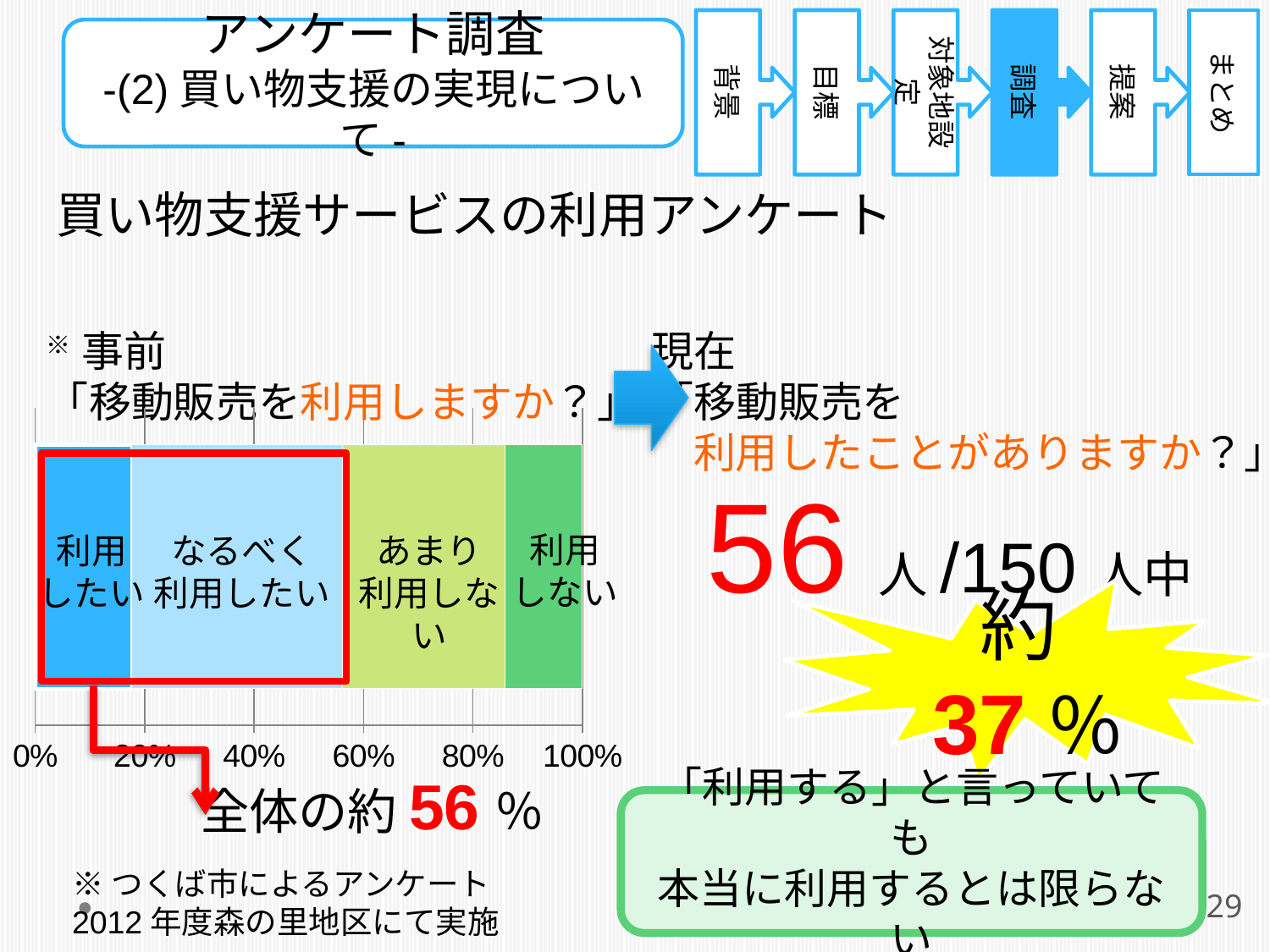
How many response categories are shown in the stacked bar? 4 Is the segment for なるべく利用したい greater or less than 20%? greater Is the segment for 利用しない greater or less than 20%? less Which two response categories are enclosed by the red box on the bar chart? 利用したい and なるべく利用したい What kind of chart is shown on the slide? Stacked bar chart Is the segment for 利用したい greater or less than 20%? less Which segment is larger, なるべく利用したい or 利用したい? なるべく利用したい Which segment is larger, あまり利用しない or 利用しない? あまり利用しない Which response category occupies the largest segment of the bar? なるべく利用したい According to the text below the chart, what share of the total do the red-boxed segments represent? 約56% What is the highest value shown on the percentage axis of the bar chart? 100%